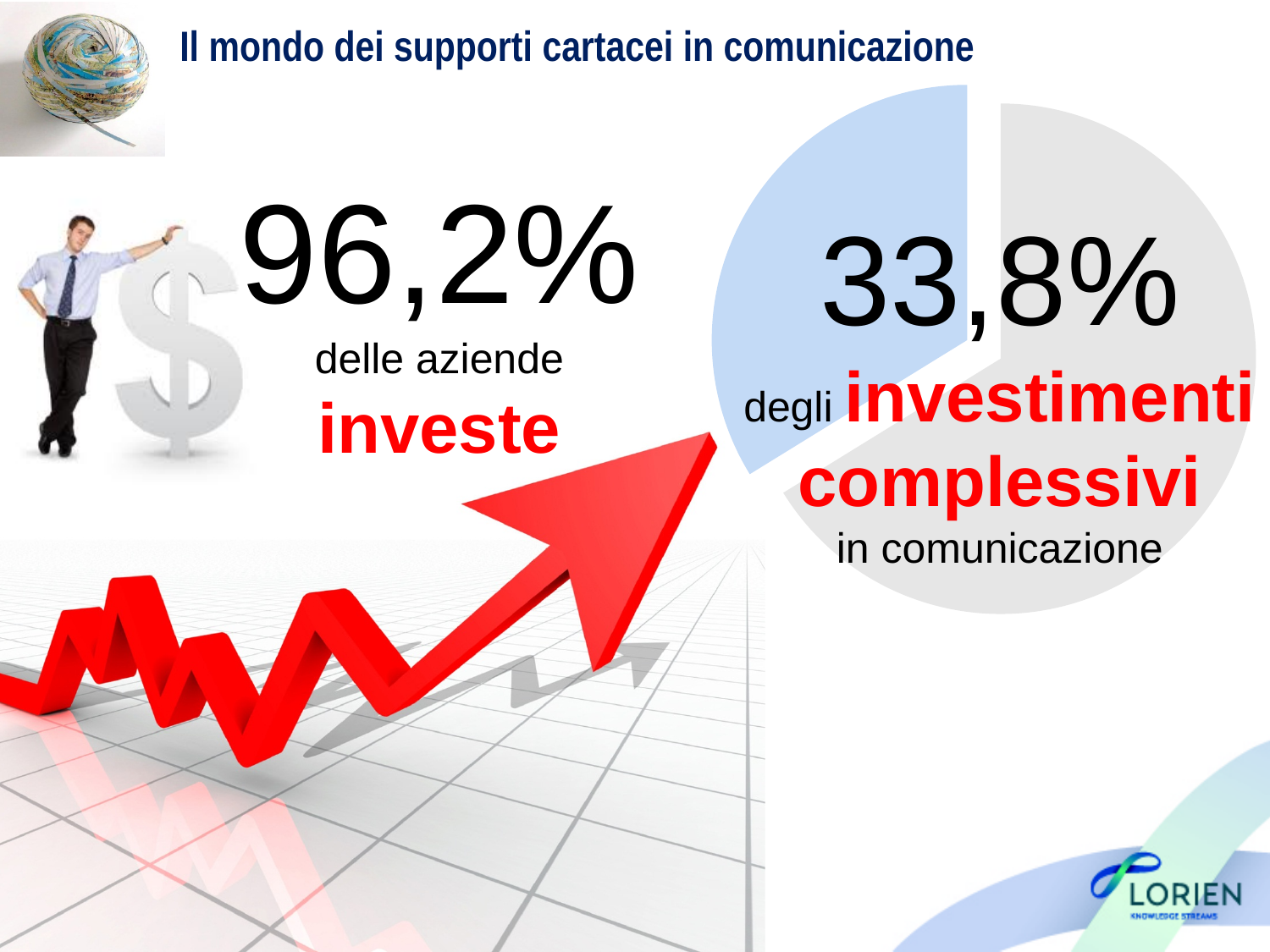
Which slice of the pie chart is larger, the blue one or the grey one? grey According to the text on the pie chart, what does the 33,8% slice represent? degli investimenti complessivi in comunicazione Which slice of the pie chart is the smallest? the blue slice What share of the pie chart does the blue slice represent? 33,8% Is the blue slice of the pie chart greater or less than half of the pie? less How many slices does the pie chart on the right have? 2 Which slice of the pie chart is the largest? the grey slice What kind of chart is shown on the right side of the slide? pie chart What colour is the slice of the pie chart that is pulled out from the rest? blue